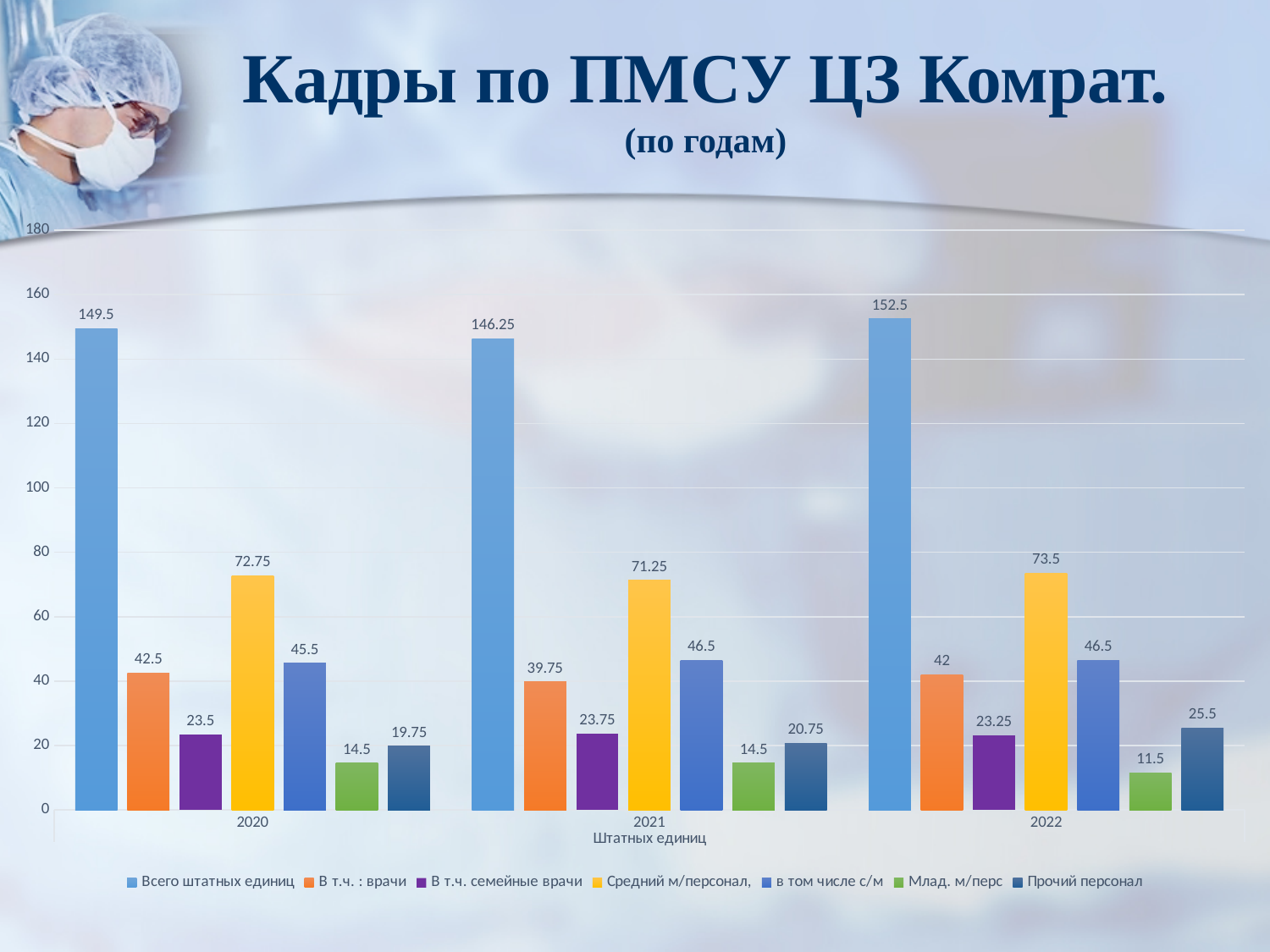
What is the value of "Всего штатных единиц" for 2022? 152.5 In which year is "Всего штатных единиц" the highest? 2022 What is the value of "В т.ч. : врачи" for 2021? 39.75 What is the difference between "Всего штатных единиц" in 2022 and in 2021? 6.25 What is the x-axis title of the chart? Штатных единиц What kind of chart is shown on the slide? Bar chart In which year is "Млад. м/перс" the lowest? 2022 Which is larger: "Прочий персонал" in 2022 or in 2020? 2022 How many series does the legend list? 7 What is the value of "Прочий персонал" for 2021? 20.75 How many years are shown on the x axis? 3 What is the value of "Средний м/персонал" for 2020? 72.75